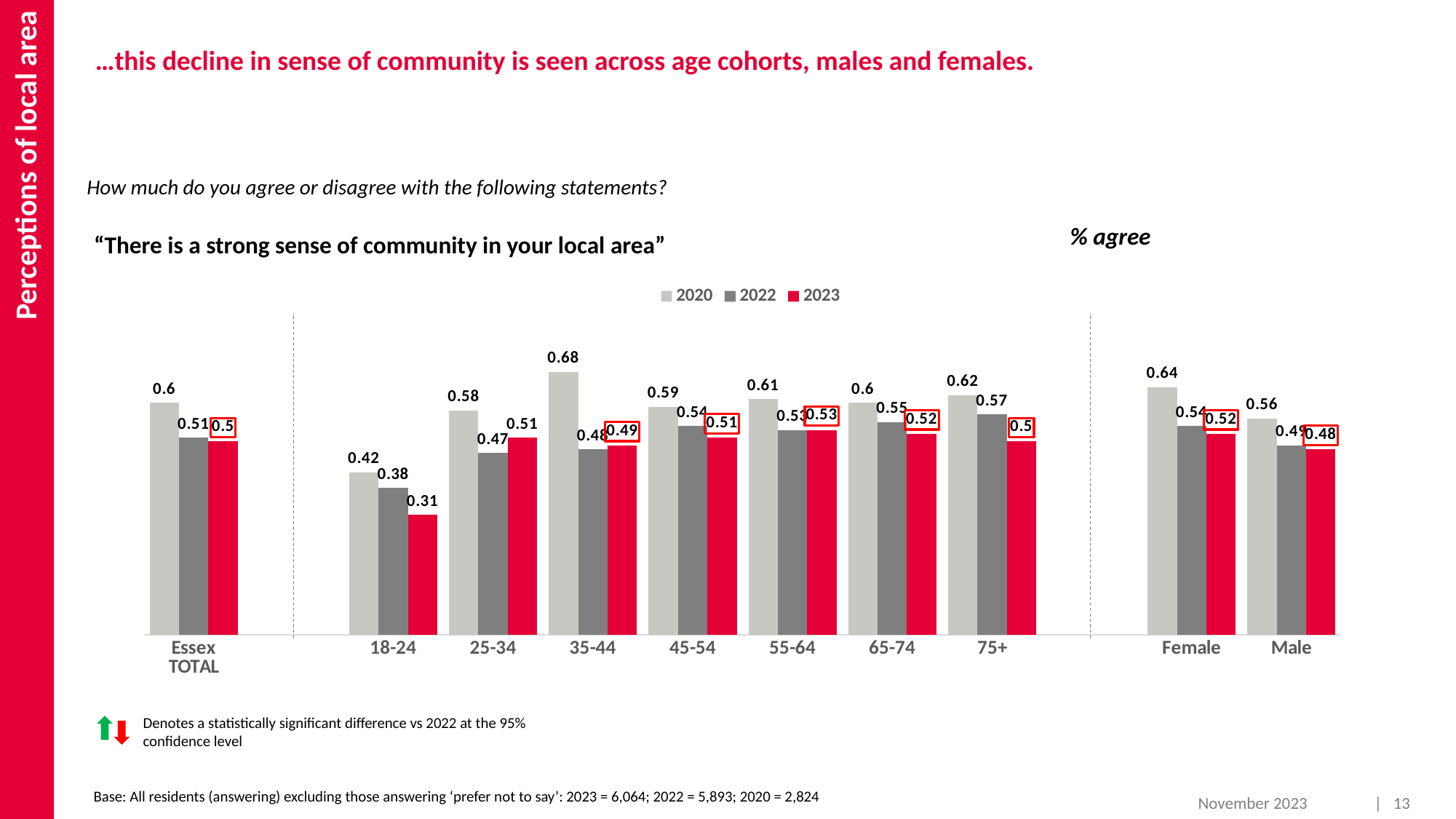
Which category has the lowest 2023 value? 18-24 Which category has the highest 2020 value? 35-44 What is the 2023 value for the 18-24 age group? 0.31 How many categories are shown on the x axis? 10 What is the 2022 value for the 75+ age group? 0.57 What kind of chart is shown on the slide? Bar chart Which is larger for the 25-34 age group: the 2022 value or the 2023 value? 2023 What is the difference between the 2020 and 2023 values for the 35-44 age group? 0.19 What is the 2020 value for Female? 0.64 How many series does the legend list? 3 What is the 2023 value for Essex TOTAL? 0.5 What is the difference between the Female and Male 2023 values? 0.04